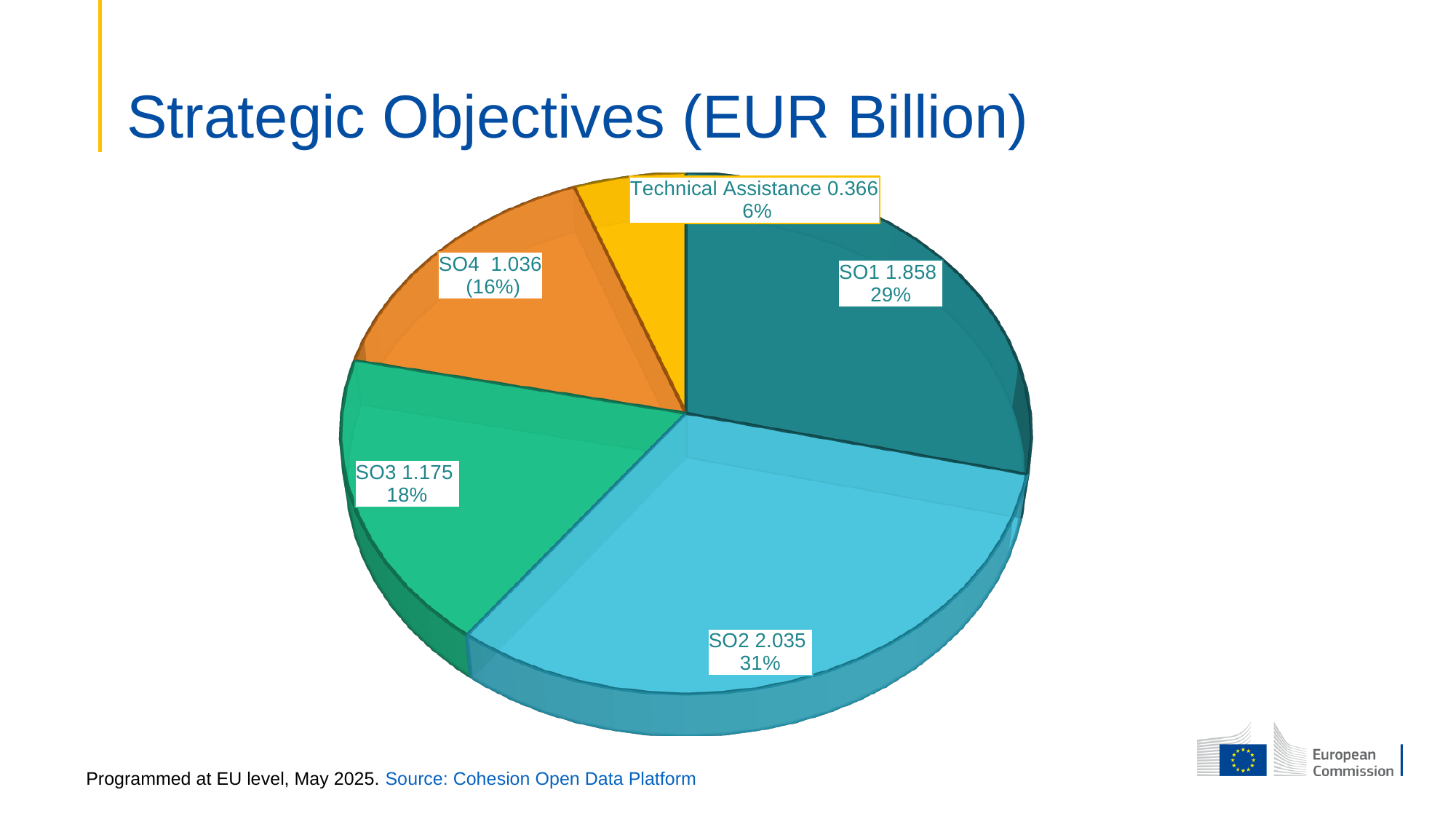
What is the value for Technical Assistance? 0.366 What is the title of the chart? Strategic Objectives (EUR Billion) How many slices does the pie chart have? 5 Which is larger, the value for SO3 or the value for SO4? SO3 What share of the pie does SO4 represent? 16% What is the value for SO1? 1.858 What is the value for SO2? 2.035 What share of the pie does SO3 represent? 18% What kind of chart is shown on the slide? Pie chart What is the difference between the values for SO2 and SO1? 0.177 Which category has the smallest slice? Technical Assistance Which category has the largest slice? SO2